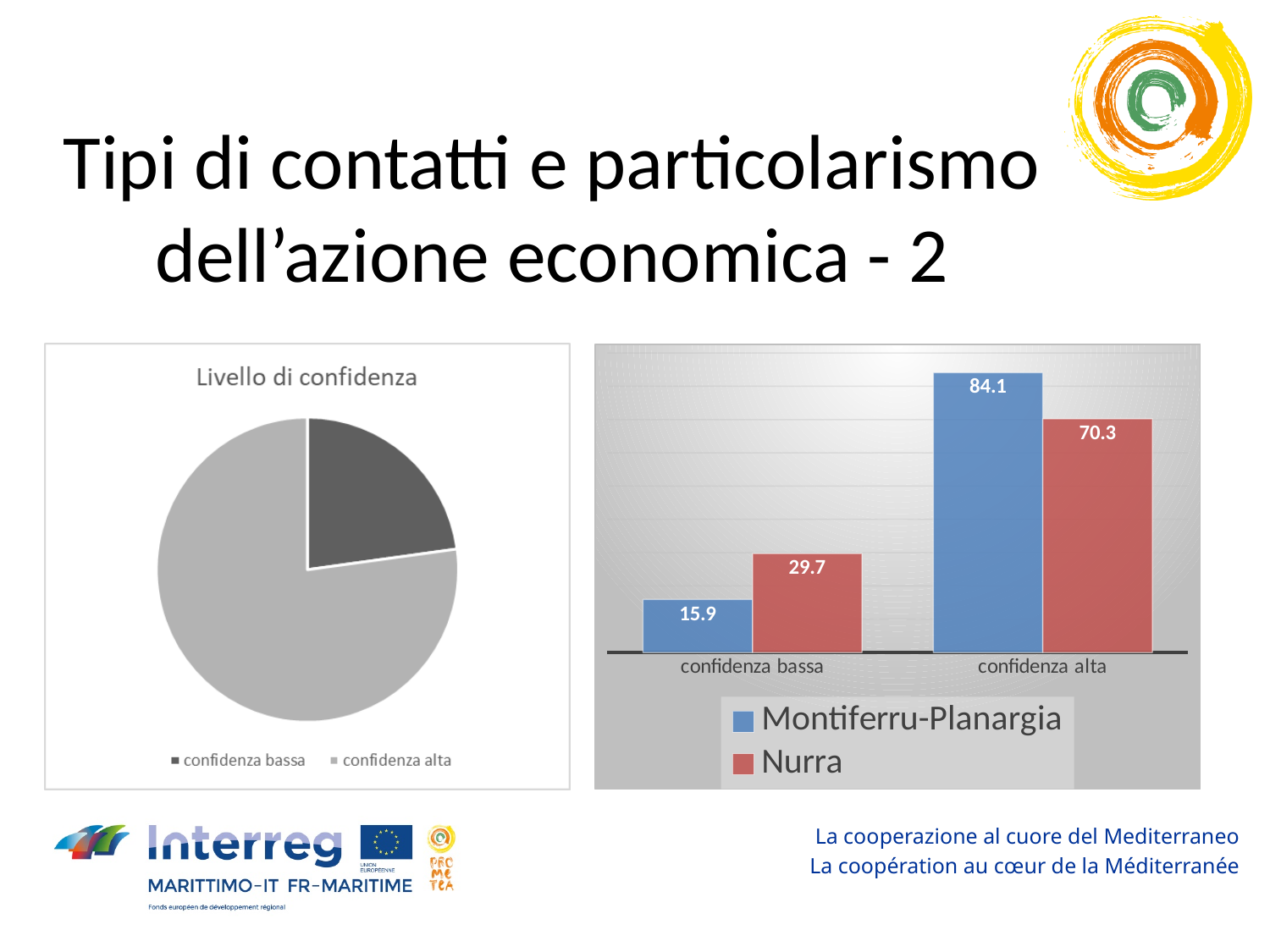
How many series does the legend of the bar chart on the right list? 2 In the bar chart on the right, what is the difference between the Montiferru-Planargia and Nurra values for 'confidenza alta'? 13.8 In the bar chart on the right, what is the value for Nurra in the 'confidenza alta' category? 70.3 In the bar chart on the right, what is the value for Montiferru-Planargia in the 'confidenza alta' category? 84.1 In the bar chart on the right, what is the difference between the Nurra and Montiferru-Planargia values for 'confidenza bassa'? 13.8 In the bar chart on the right, which series has the higher value for 'confidenza bassa'? Nurra In the bar chart on the right, what is the value for Montiferru-Planargia in the 'confidenza bassa' category? 15.9 In the bar chart on the right, which series has the higher value for 'confidenza alta'? Montiferru-Planargia In the bar chart on the right, what is the value for Nurra in the 'confidenza bassa' category? 29.7 In the pie chart titled 'Livello di confidenza', which slice is larger, 'confidenza bassa' or 'confidenza alta'? confidenza alta How many categories are shown on the x axis of the bar chart on the right? 2 What kind of chart is the chart titled 'Livello di confidenza' on the left? Pie chart